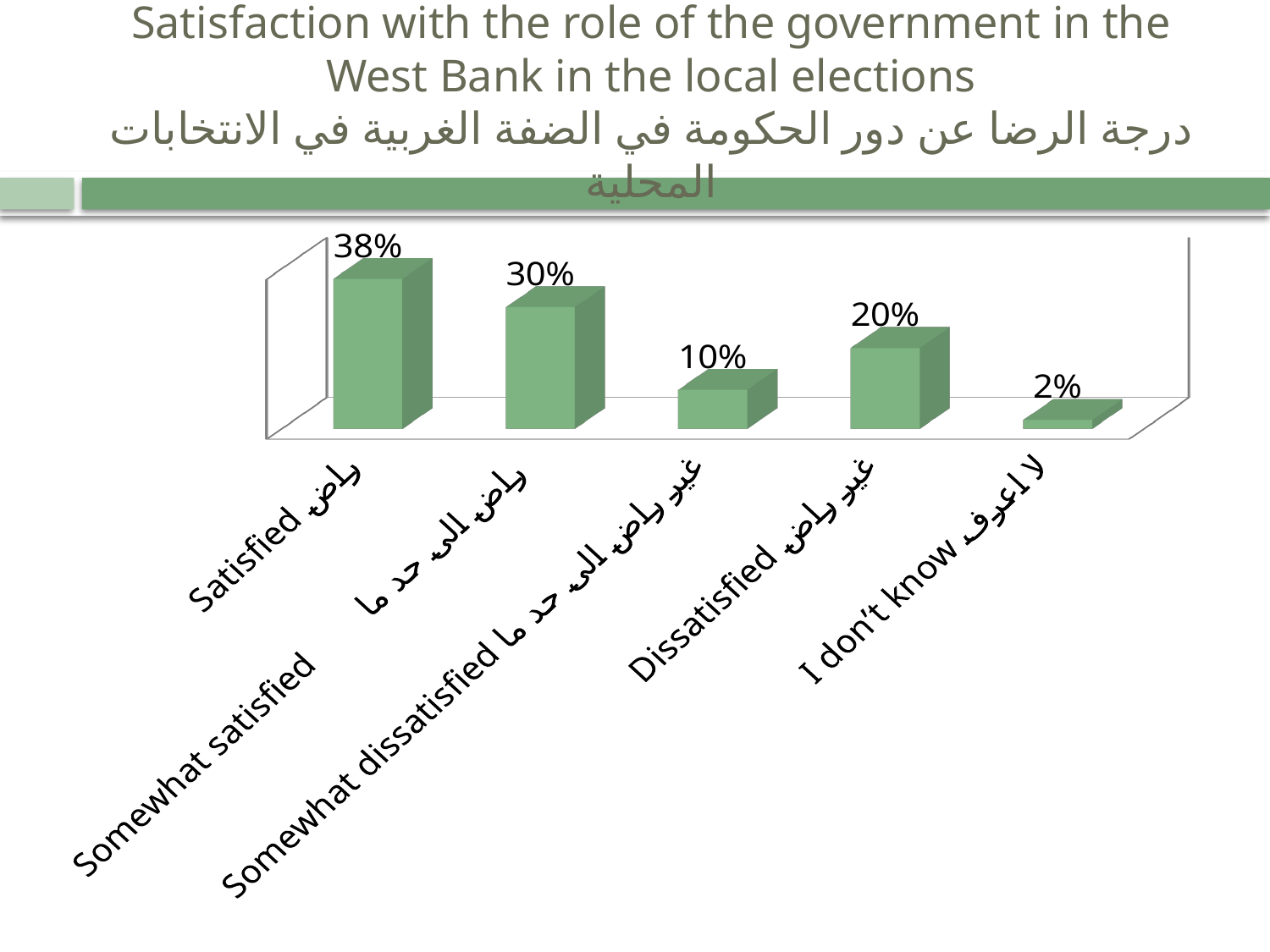
Which is larger, the value for Somewhat satisfied or the value for Dissatisfied? Somewhat satisfied What is the value for Satisfied? 38% What is the value for Somewhat dissatisfied? 10% What kind of chart is shown on the slide? Bar chart How many categories are shown in the chart? 5 What is the value for Dissatisfied? 20% What is the difference between the values for Satisfied and Dissatisfied? 18% What is the value for Somewhat satisfied? 30% What is the difference between the values for Somewhat satisfied and Somewhat dissatisfied? 20% Which category has the lowest value? I don't know Which category has the highest value? Satisfied What is the value for I don't know? 2%